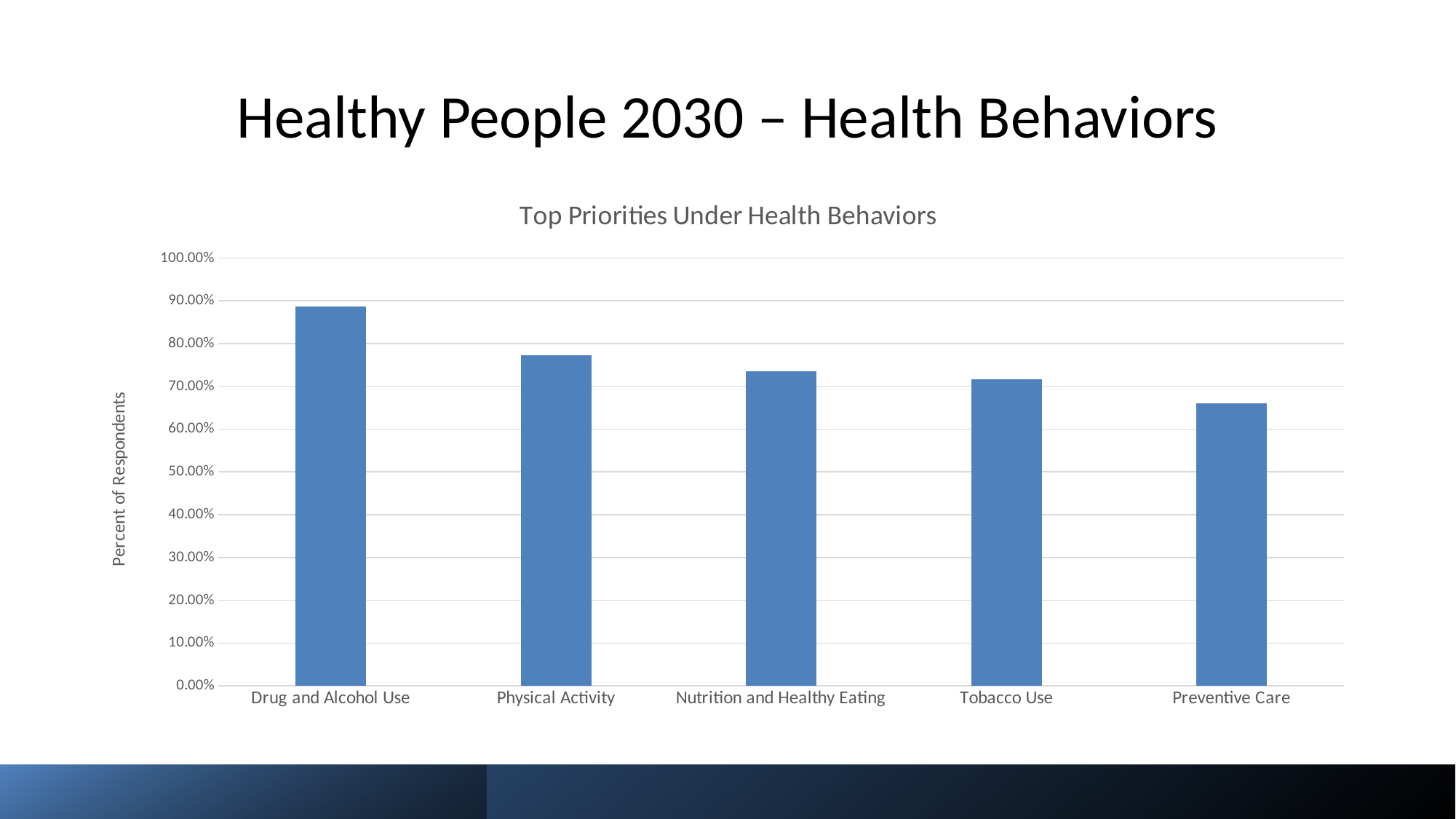
Do the values rise or fall moving from left to right along the x axis? Fall How many categories are shown on the x axis? 5 What is the title of the chart? Top Priorities Under Health Behaviors Is the value for Physical Activity greater or less than 80.00%? less What type of chart is shown on the slide? Bar chart Which category has the lowest value? Preventive Care What is the label of the vertical axis? Percent of Respondents Which category has the highest value? Drug and Alcohol Use Which is larger, the value for Physical Activity or the value for Preventive Care? Physical Activity Is the value for Preventive Care greater or less than 70.00%? less Is the value for Drug and Alcohol Use greater or less than 80.00%? greater